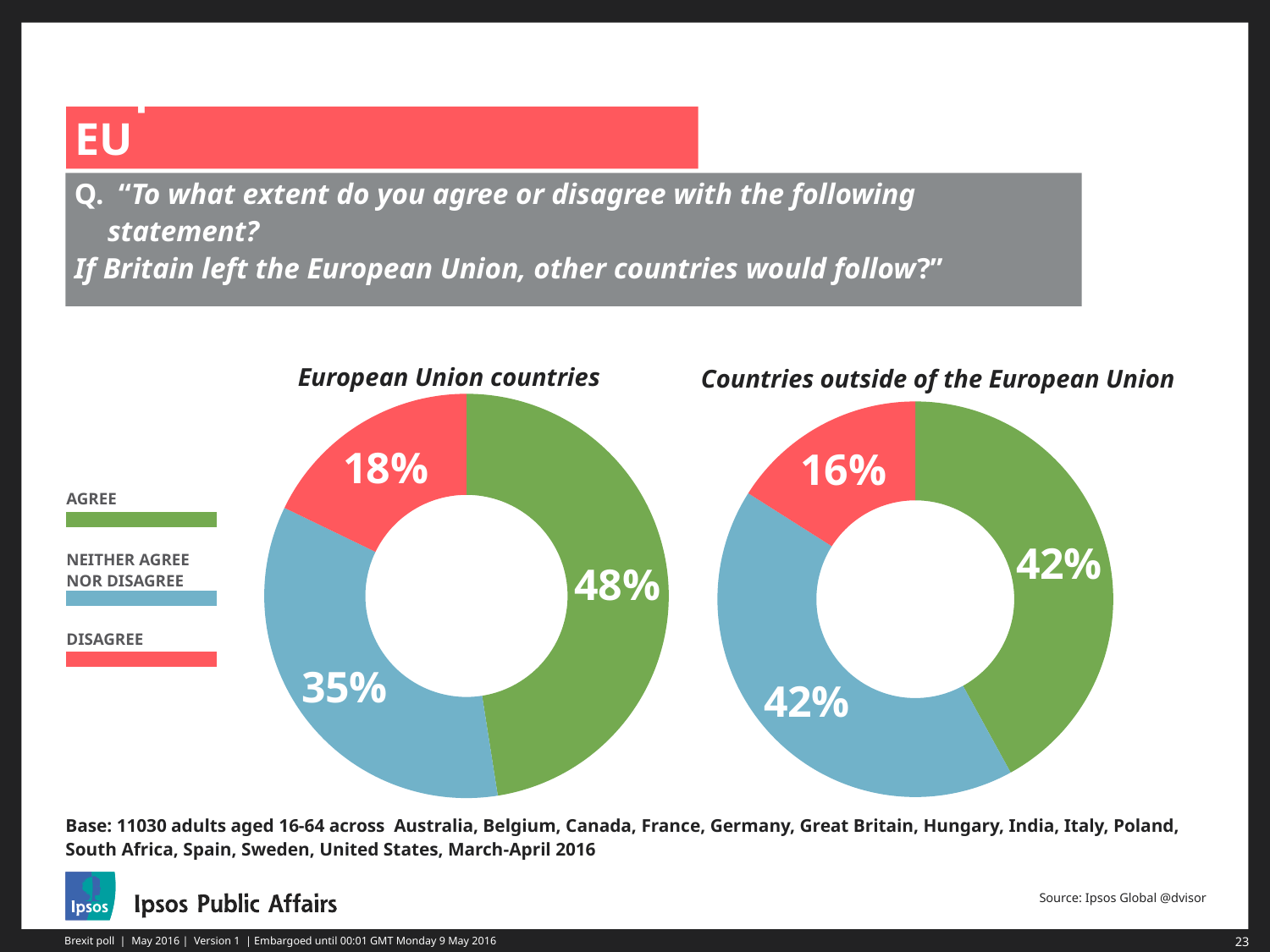
In the 'European Union countries' chart, what is the difference between the Agree and Disagree shares? 30 percentage points In the 'Countries outside of the European Union' chart, what percentage agree? 42% In the 'European Union countries' chart, what percentage neither agree nor disagree? 35% In the 'European Union countries' chart, what percentage agree that other countries would follow if Britain left the EU? 48% In the 'Countries outside of the European Union' chart, which response has the smallest share? Disagree In the 'Countries outside of the European Union' chart, what percentage disagree? 16% In the 'European Union countries' chart, what percentage disagree? 18% Which colour represents 'Neither agree nor disagree' in the charts? Blue What type of chart is used on this slide? Donut (pie) chart In the 'European Union countries' chart, which response has the largest share? Agree Which chart shows a higher Disagree share, 'European Union countries' or 'Countries outside of the European Union'? European Union countries How many response categories does the legend list? 3